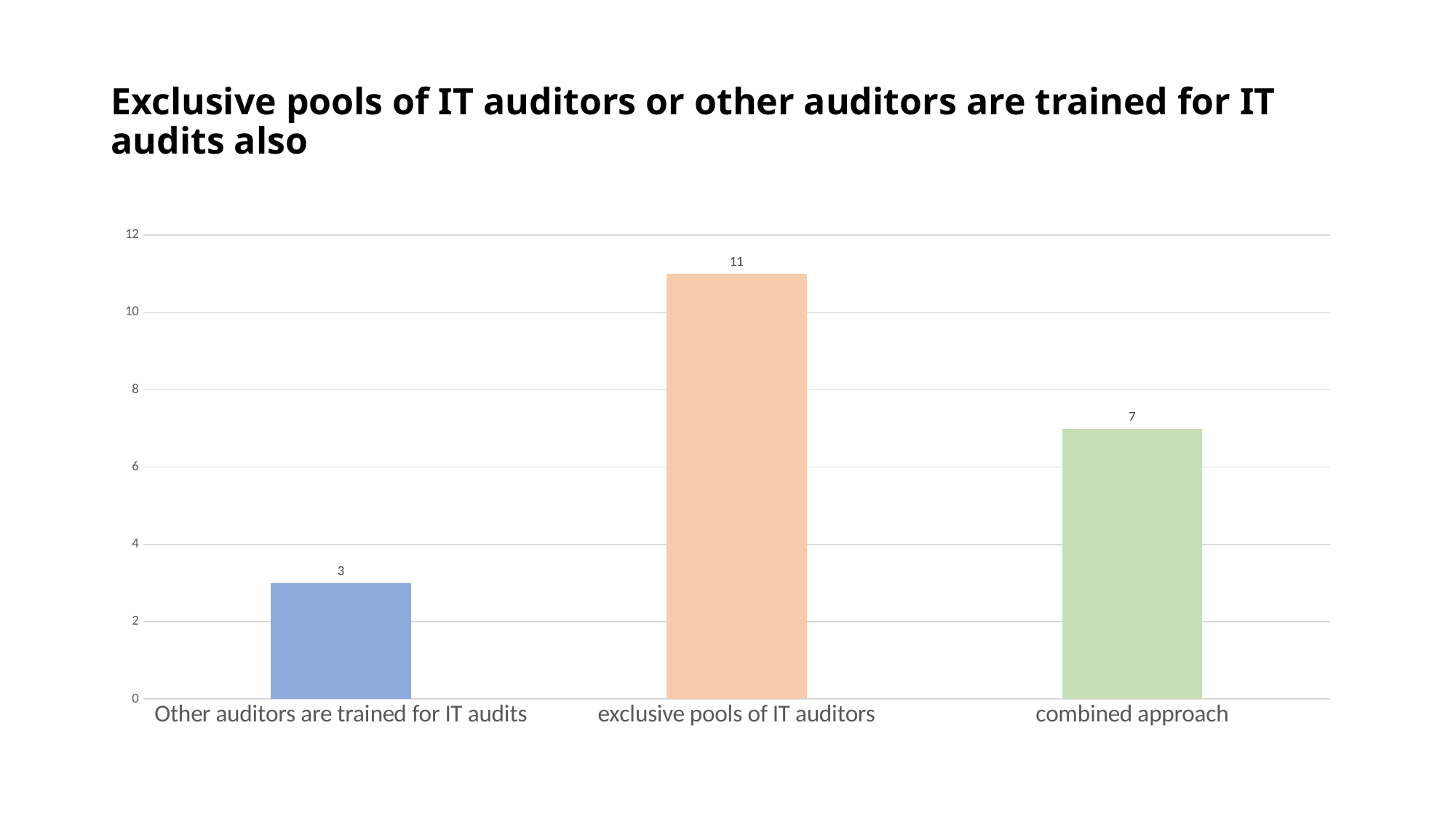
What kind of chart is shown on the slide? bar chart What is the title of the slide? Exclusive pools of IT auditors or other auditors are trained for IT audits also What is the difference between the values for "exclusive pools of IT auditors" and "combined approach"? 4 How many categories are shown on the chart? 3 Is the value for "exclusive pools of IT auditors" greater or less than 10? greater What is the value for "combined approach"? 7 What is the value for "exclusive pools of IT auditors"? 11 What is the value for "Other auditors are trained for IT audits"? 3 Which is larger, the value for "combined approach" or the value for "Other auditors are trained for IT audits"? combined approach Which category has the lowest value? Other auditors are trained for IT audits What is the difference between the values for "combined approach" and "Other auditors are trained for IT audits"? 4 Which category has the highest value? exclusive pools of IT auditors